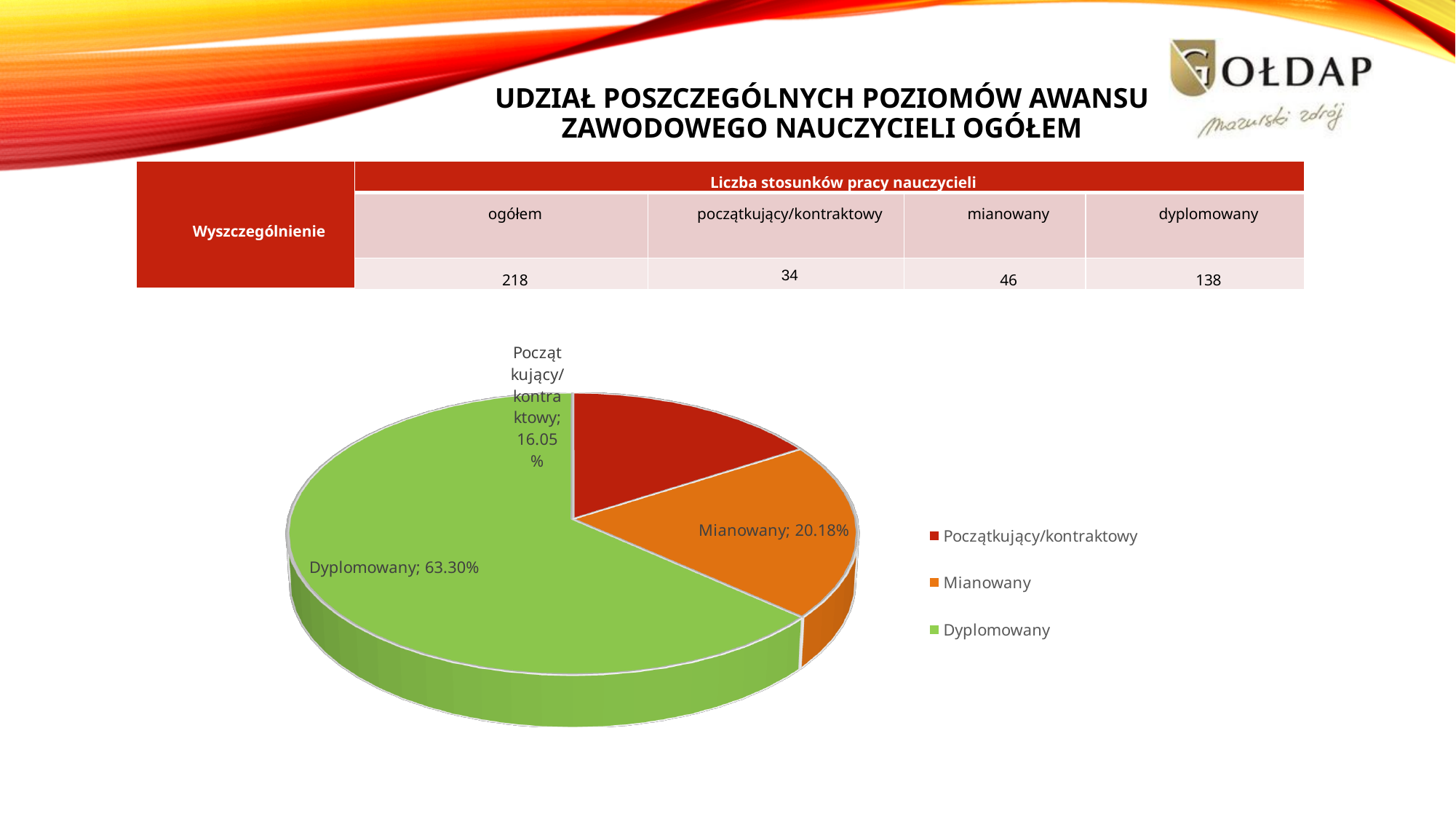
Which category has the smallest slice of the pie? Początkujący/kontraktowy What colour is the Mianowany slice in the pie chart? orange What share of the pie does Dyplomowany have? 63.30% Which category has the largest slice of the pie? Dyplomowany How many entries does the legend list? 3 What is the difference in percentage points between the Dyplomowany and Mianowany slices? 43.12 What share of the pie does Mianowany have? 20.18% Which slice is larger, Mianowany or Początkujący/kontraktowy? Mianowany What share of the pie does Początkujący/kontraktowy have? 16.05% How many slices does the pie chart have? 3 What colour is the Dyplomowany slice in the pie chart? green What kind of chart is shown on the slide? pie chart